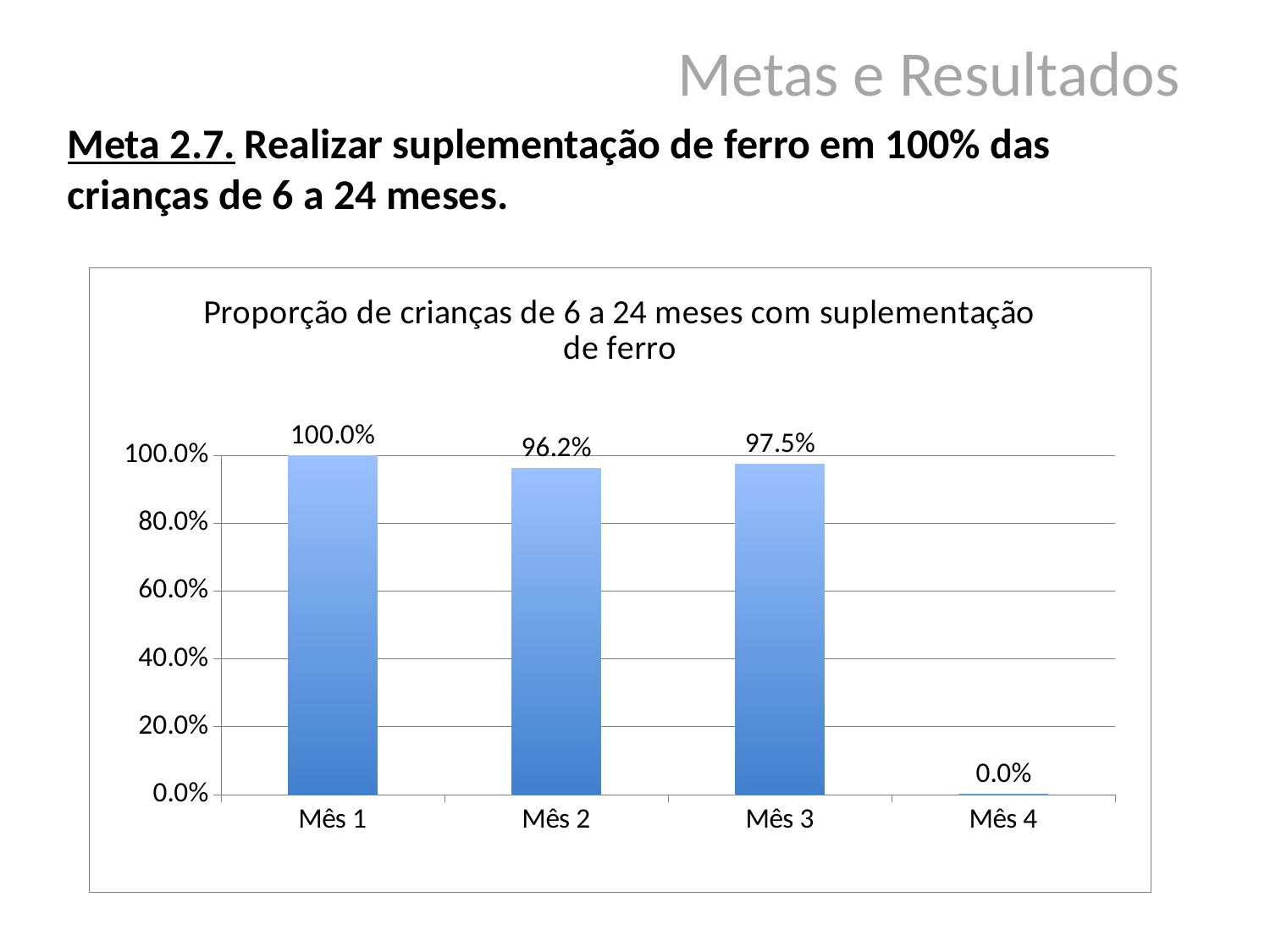
What is the title of the chart? Proporção de crianças de 6 a 24 meses com suplementação de ferro Which month has the highest value? Mês 1 What is the value for Mês 4? 0.0% Which month has the lowest value? Mês 4 What is the value for Mês 2? 96.2% What is the difference between the values for Mês 1 and Mês 2? 3.8% What is the difference between the values for Mês 3 and Mês 2? 1.3% How many months are shown on the x axis? 4 What is the value for Mês 3? 97.5% What kind of chart is shown on the slide? Bar chart Which is larger, the value for Mês 2 or the value for Mês 3? Mês 3 What is the value for Mês 1? 100.0%